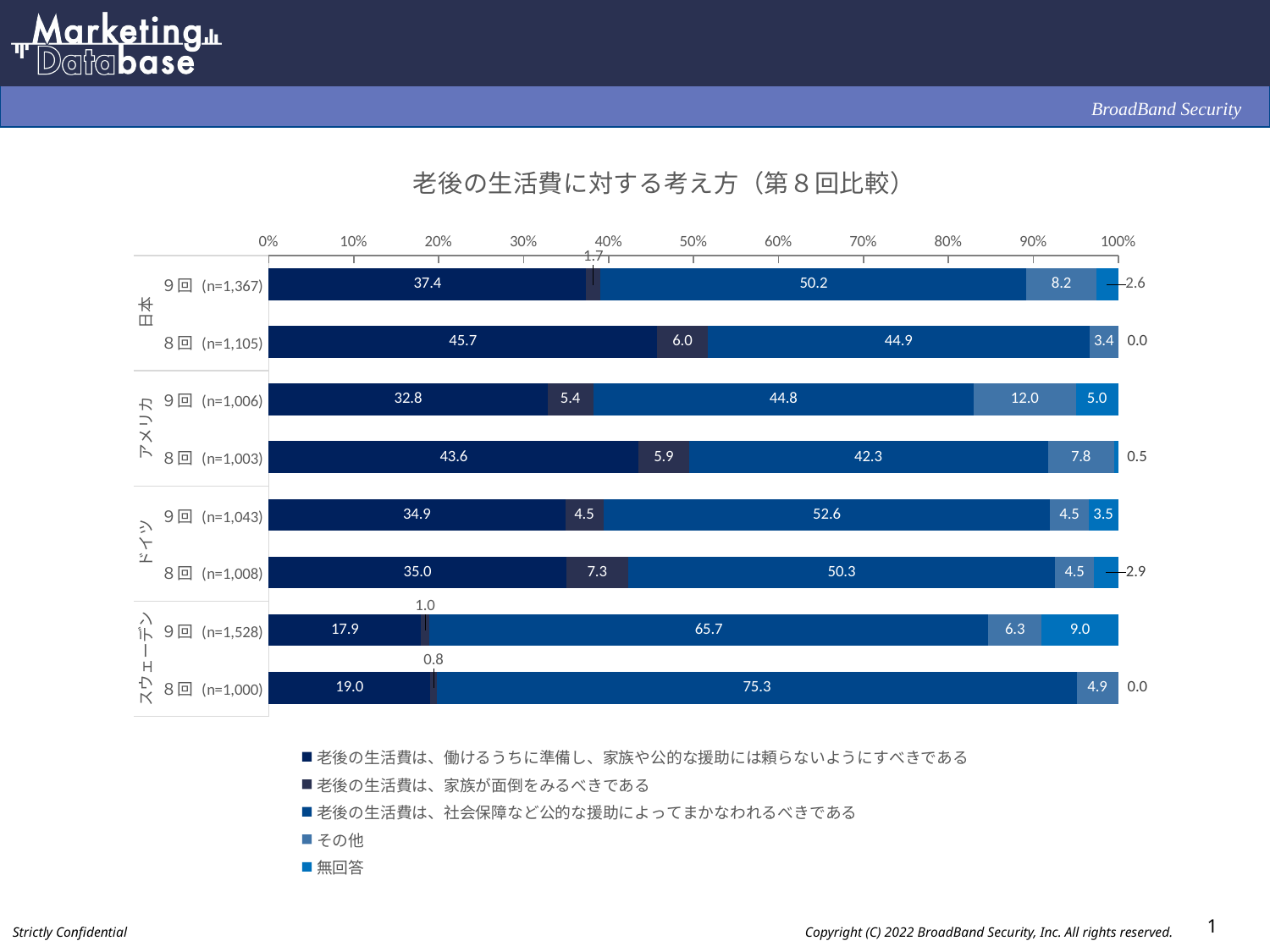
What is the title of the chart? 老後の生活費に対する考え方（第8回比較） What is the difference between the 「老後の生活費は、働けるうちに準備し、家族や公的な援助には頼らないようにすべきである」 values for 日本 8回 (n=1,105) and 日本 9回 (n=1,367)? 8.3 What is the value for 「無回答」 for スウェーデン 9回 (n=1,528)? 9.0 How many series does the legend list? 5 Which row has the highest value for 「老後の生活費は、社会保障など公的な援助によってまかなわれるべきである」? スウェーデン 8回 (n=1,000) What is the value for 「老後の生活費は、働けるうちに準備し、家族や公的な援助には頼らないようにすべきである」 for 日本 8回 (n=1,105)? 45.7 Which row has the lowest value for 「老後の生活費は、働けるうちに準備し、家族や公的な援助には頼らないようにすべきである」? スウェーデン 9回 (n=1,528) What is the value for 「その他」 for アメリカ 9回 (n=1,006)? 12.0 What type of chart is shown on the slide? Stacked bar chart What is the value for 「老後の生活費は、社会保障など公的な援助によってまかなわれるべきである」 for スウェーデン 8回 (n=1,000)? 75.3 How many bars (survey rows) are plotted in the chart? 8 Which is larger: the 「老後の生活費は、家族が面倒をみるべきである」 value for ドイツ 8回 (n=1,008) or for ドイツ 9回 (n=1,043)? ドイツ 8回 (n=1,008)